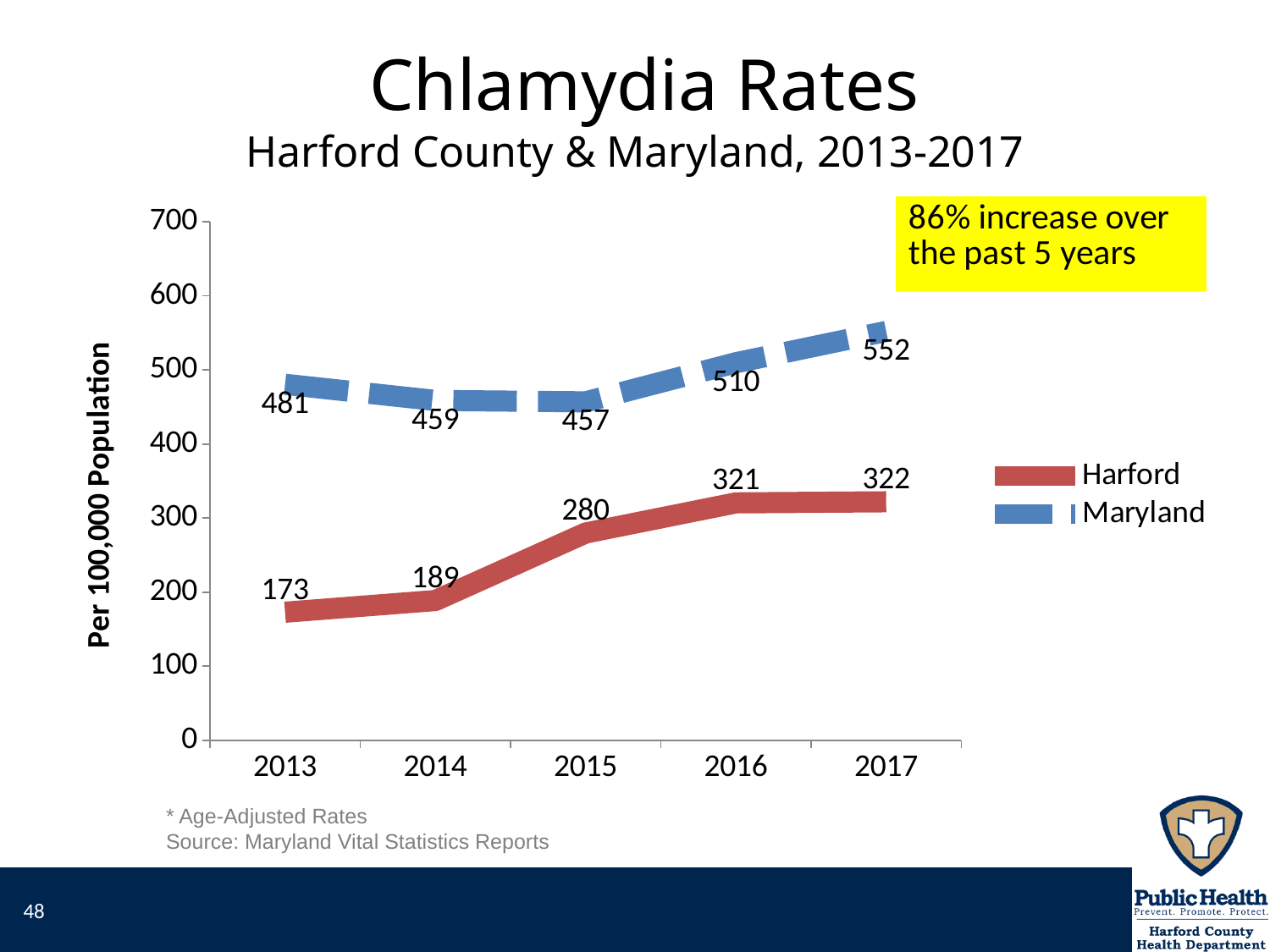
How many years are shown on the x axis? 5 What was the Harford chlamydia rate in 2013? 173 What was the Maryland chlamydia rate in 2017? 552 In which year was the Maryland rate lowest? 2015 By how much did the Harford rate increase from 2014 to 2015? 91 Does the Harford rate rise or fall from 2013 to 2017? Rise What is the difference between the Maryland and Harford rates in 2013? 308 In which year was the Harford rate highest? 2017 What was the Harford chlamydia rate in 2015? 280 What kind of chart is shown on the slide? Line chart Which was higher in 2016, the Harford rate or the Maryland rate? Maryland How many series does the legend list? 2